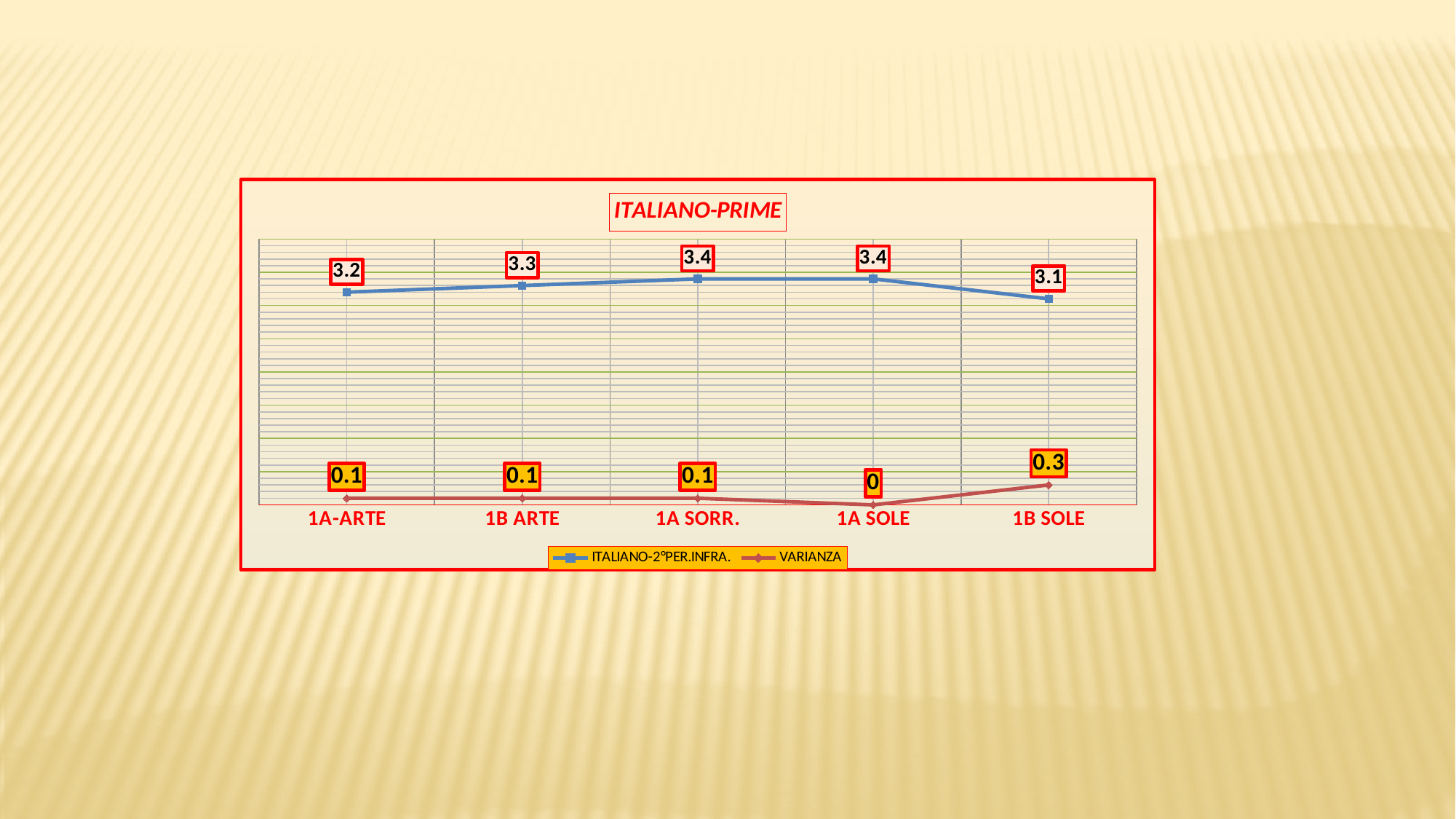
What is the value of ITALIANO-2°PER.INFRA. for 1A SORR.? 3.4 What is the title of the chart? ITALIANO-PRIME What is the VARIANZA value for 1B SOLE? 0.3 What kind of chart is shown? Line chart Which category has the lowest ITALIANO-2°PER.INFRA. value? 1B SOLE What is the value of ITALIANO-2°PER.INFRA. for 1B SOLE? 3.1 How many categories are shown on the x axis? 5 What is the difference between the ITALIANO-2°PER.INFRA. values for 1A SOLE and 1B SOLE? 0.3 What is the VARIANZA value for 1A SOLE? 0 How many series does the legend list? 2 Which category has the highest VARIANZA value? 1B SOLE Which is larger, the ITALIANO-2°PER.INFRA. value for 1A-ARTE or for 1B ARTE? 1B ARTE